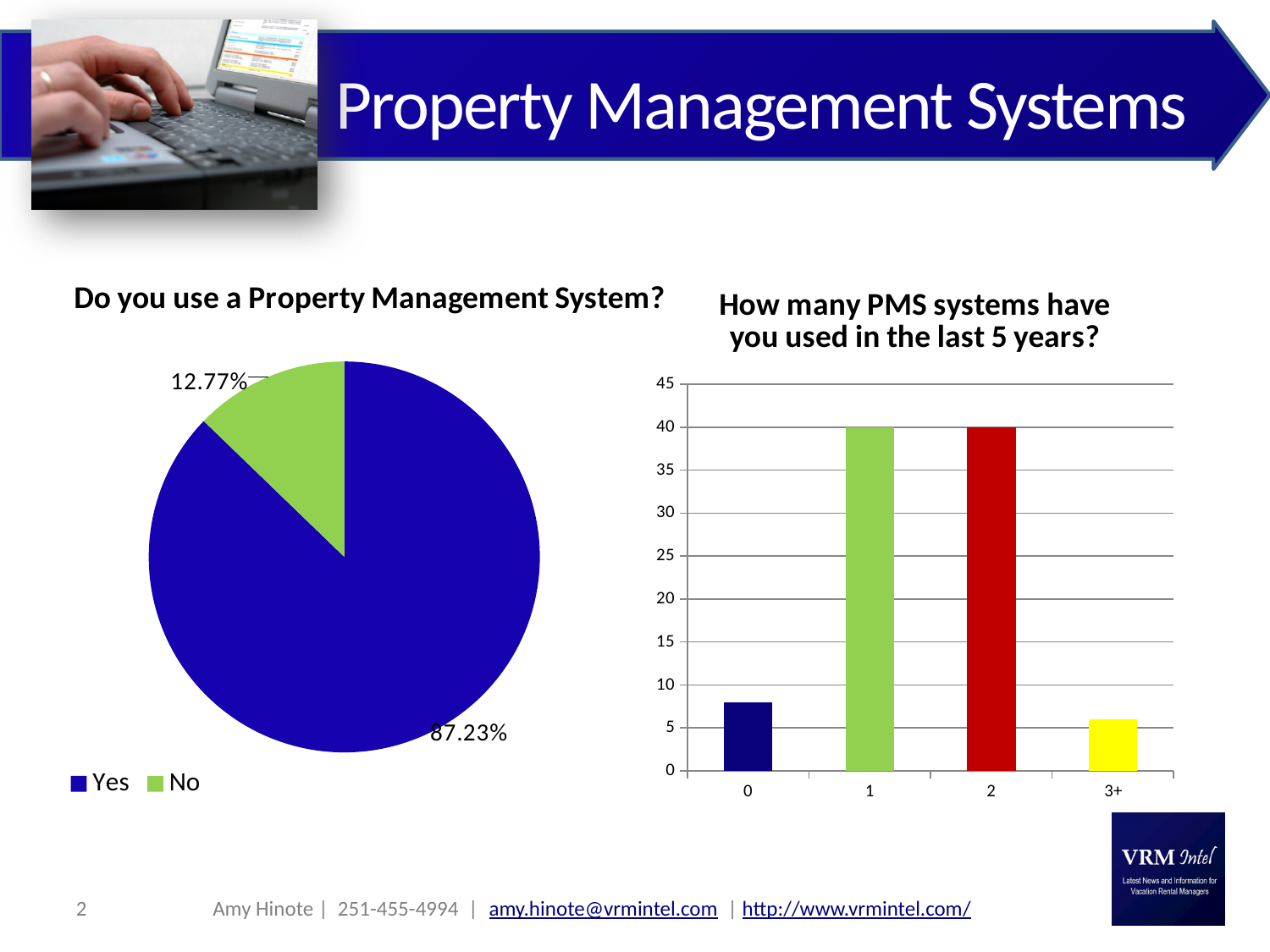
In the pie chart 'Do you use a Property Management System?', what is the difference in percentage points between Yes and No? 74.46 In the chart 'How many PMS systems have you used in the last 5 years?', is the value for category 0 greater or less than 10? less In the chart 'How many PMS systems have you used in the last 5 years?', what is the value for category 1? 40 In the chart 'How many PMS systems have you used in the last 5 years?', is the value for category 3+ greater or less than 5? greater In the pie chart 'Do you use a Property Management System?', what percentage answered No? 12.77% In the chart 'How many PMS systems have you used in the last 5 years?', which category has the lowest value? 3+ In the pie chart 'Do you use a Property Management System?', what percentage answered Yes? 87.23% In the chart 'How many PMS systems have you used in the last 5 years?', how many categories are shown on the x axis? 4 In the chart 'How many PMS systems have you used in the last 5 years?', what is the value for category 2? 40 In the pie chart 'Do you use a Property Management System?', which response has the larger share? Yes In the pie chart 'Do you use a Property Management System?', how many slices are there? 2 What type of chart is 'How many PMS systems have you used in the last 5 years?'? bar chart